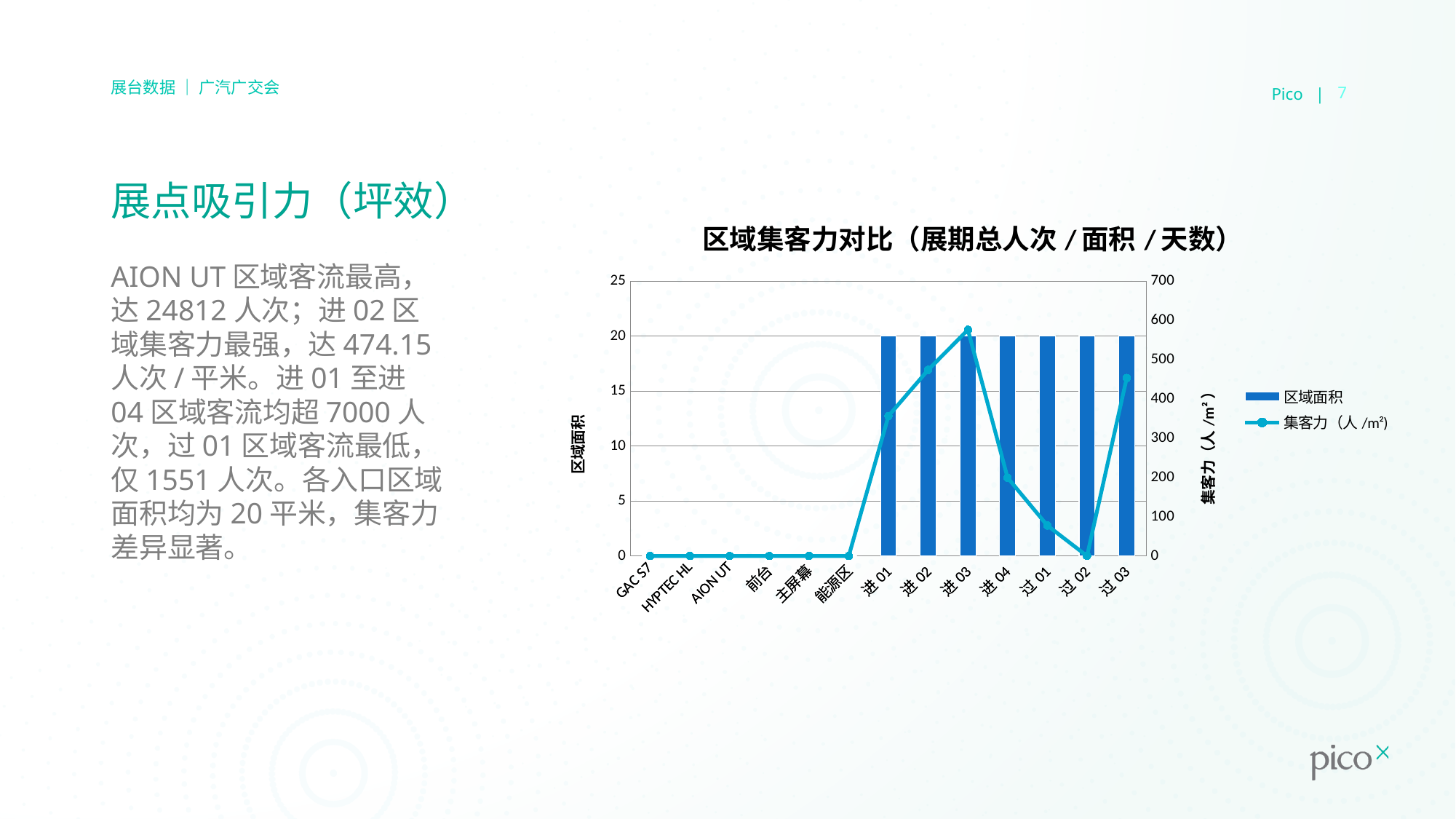
Is the 集客力 value for 过 03 greater or less than 400? greater What is the 区域面积 value for 进 01? 20 Does the 集客力 line rise or fall from 进 03 to 过 02? It falls What kind of chart is shown on the slide? A combined bar and line chart How many categories are shown along the x axis of the chart? 13 What is the 集客力 value for GAC S7? 0 Is the 集客力 value for 进 03 greater or less than 500? greater How many series does the chart legend list? 2 Which category has the highest 集客力 value? 进 03 Is the 集客力 value for 进 04 greater or less than 300? less Which has a higher 集客力 value, 进 02 or 进 04? 进 02 What is the title of the chart? 区域集客力对比（展期总人次 / 面积 / 天数）